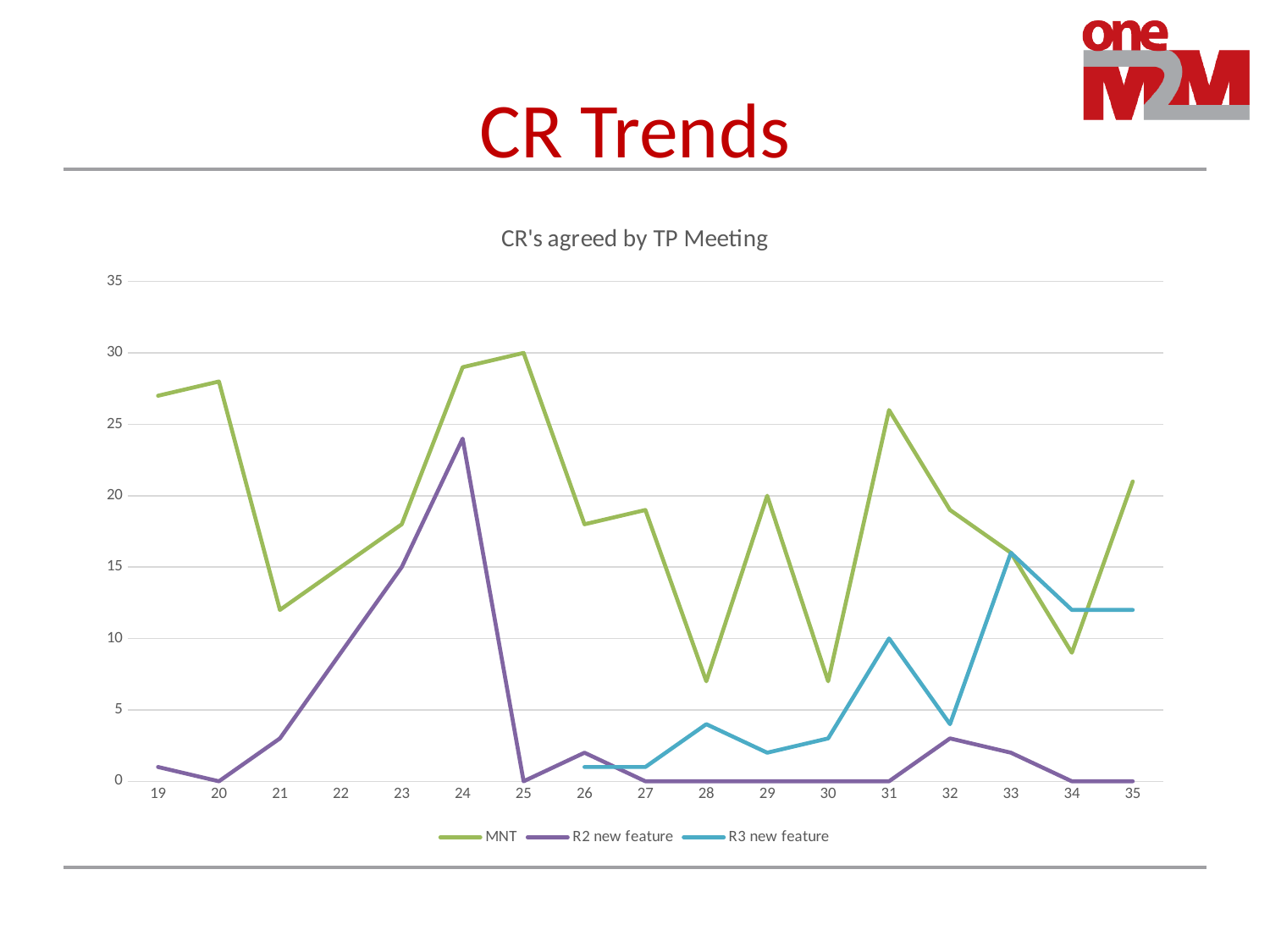
What is the R3 new feature value at TP meeting 31? 10 What is the MNT value at TP meeting 29? 20 What is the MNT value at TP meeting 25? 30 What is the title of the chart? CR's agreed by TP Meeting At which TP meeting does the R2 new feature series reach its highest value? 24 What is the R2 new feature value at TP meeting 28? 0 At which TP meeting does the MNT series reach its highest value? 25 How many TP meetings are shown along the x axis? 17 At TP meeting 35, which series is larger, MNT or R3 new feature? MNT How many series does the legend list? 3 Is the MNT value at TP meeting 21 greater or less than 15? less What kind of chart is shown on the slide? line chart